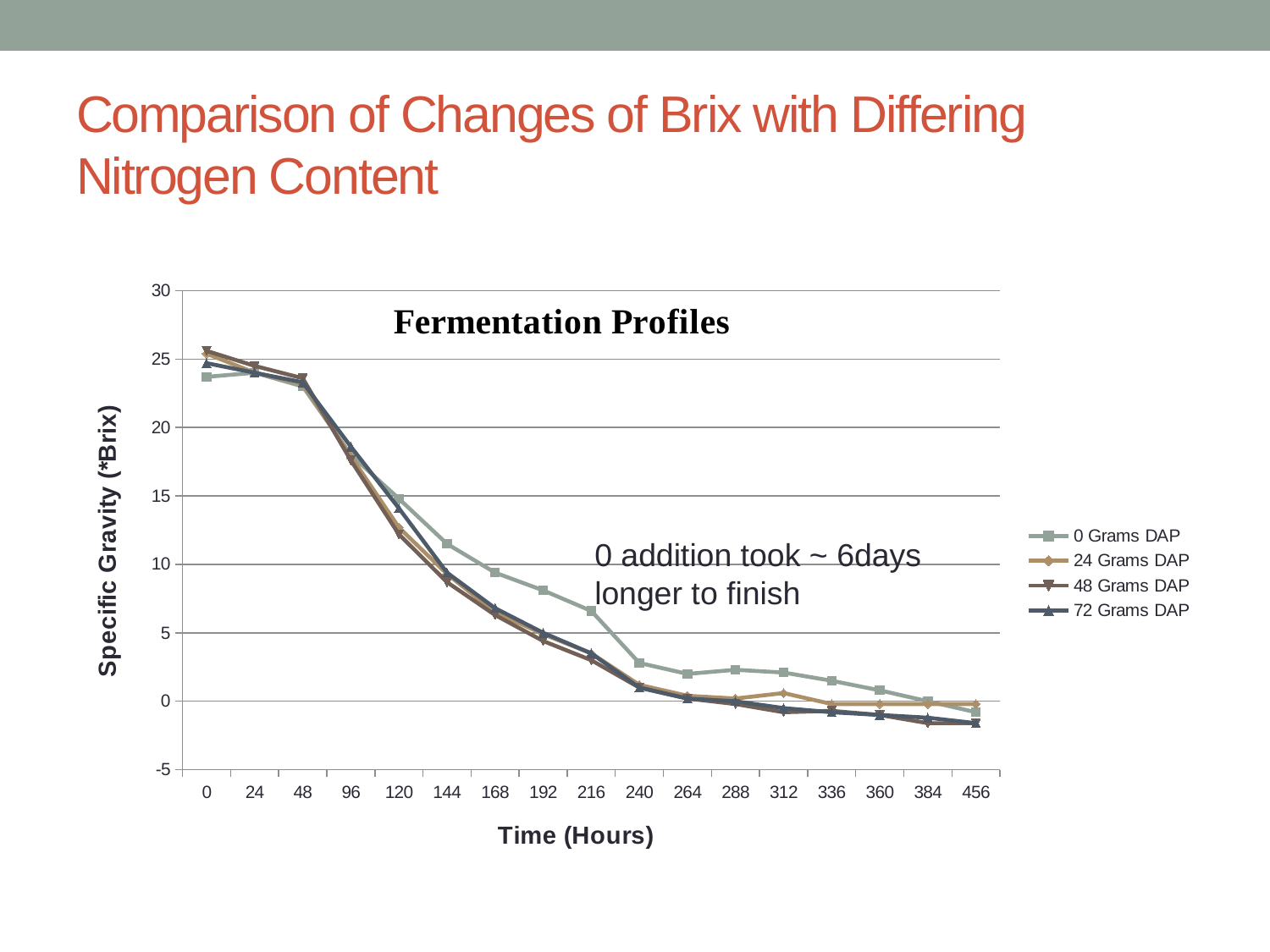
Do the values for 0 Grams DAP rise or fall as time increases along the x axis? Fall At 144 hours, which series has the higher value: 0 Grams DAP or 24 Grams DAP? 0 Grams DAP At 240 hours, which series has the higher value: 0 Grams DAP or 72 Grams DAP? 0 Grams DAP How many series does the legend list? 4 What type of chart is shown on the slide? Line chart What is the title printed inside the chart area? Fermentation Profiles Is the value for 0 Grams DAP at 0 hours greater or less than 25? less Is the value for 72 Grams DAP at 144 hours greater or less than 10? less How many time points are shown along the x axis? 17 Is the value for 0 Grams DAP at 240 hours greater or less than 5? less